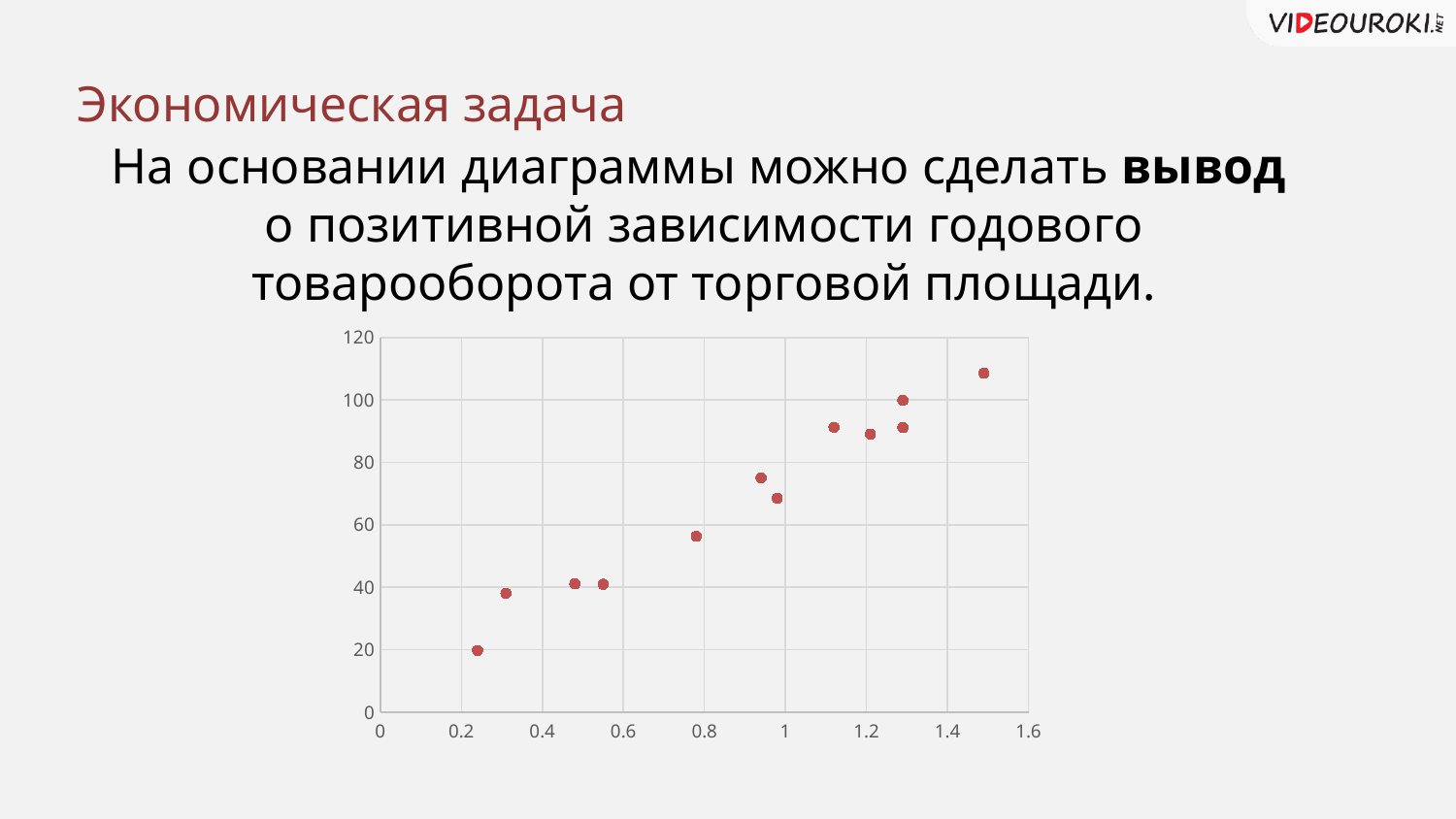
Is the y value of the leftmost point (at x of about 0.24) greater or less than 40? less Do the plotted values generally rise or fall as the x value increases? rise Is the y value of the point at x of about 1.12 greater or less than 80? greater Is the y value of the point at x of about 0.94 greater or less than 60? greater How many points have a y value below 60? 5 What is the maximum value shown on the vertical axis? 120 How many data points are plotted on the chart? 12 What is the maximum value shown on the horizontal axis? 1.6 Which point has the highest y value: the leftmost point or the rightmost point? the rightmost point What kind of chart is shown on the slide? scatter chart